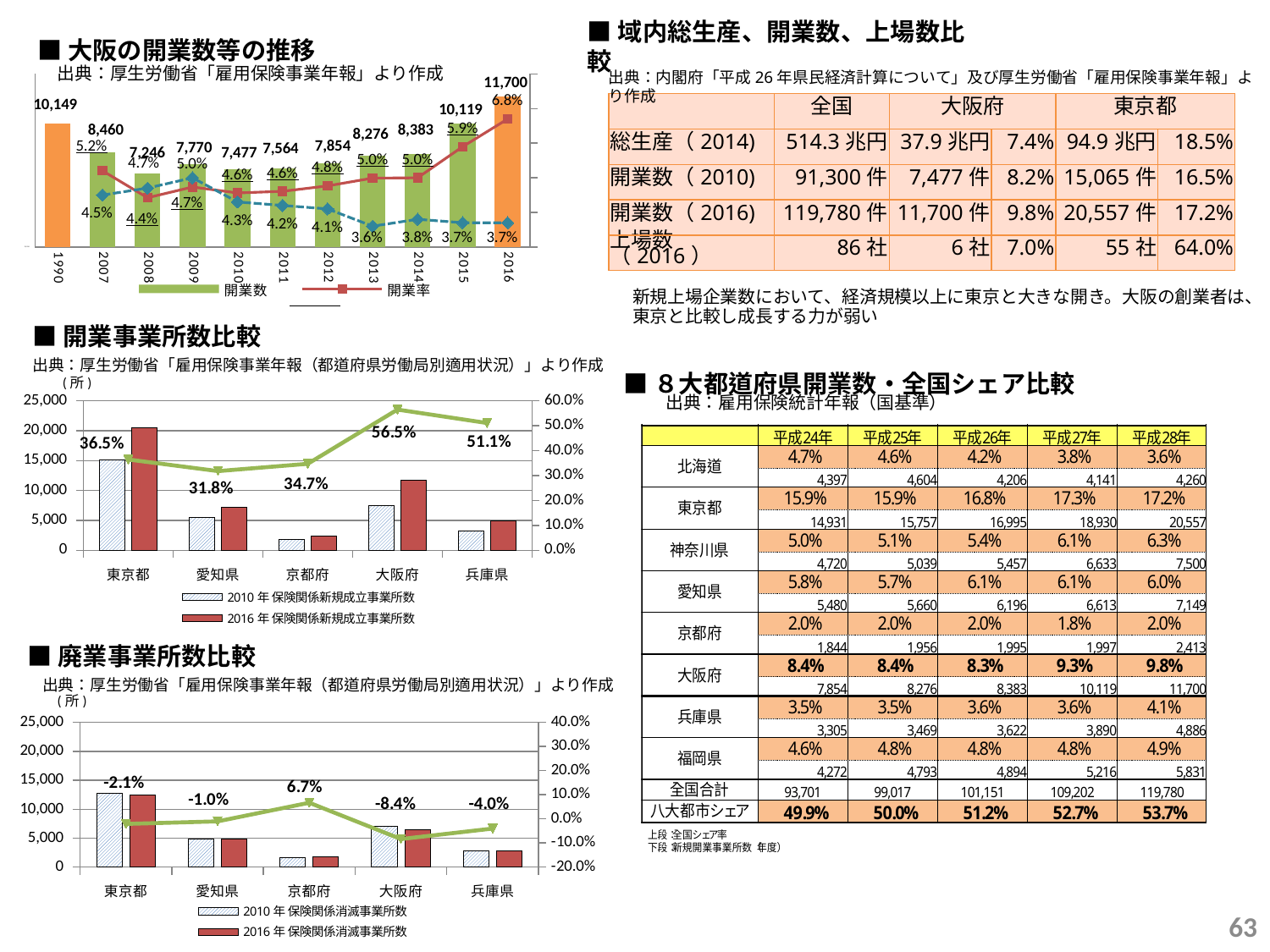
In the chart titled 開業事業所数比較, is the 2016 年 保険関係新規成立事業所数 bar for 東京都 greater or less than 15,000? greater In the chart titled 大阪の開業数等の推移, what is the 開業率 value for 2015? 5.9% In the chart titled 開業事業所数比較, which prefecture has the highest line value? 大阪府 In the chart titled 大阪の開業数等の推移, which is larger, the 開業数 for 1990 or for 2015? 1990 In the chart titled 大阪の開業数等の推移, what is the 開業数 value for 2016? 11,700 In the chart titled 廃業事業所数比較, which prefecture has the lowest line value? 大阪府 In the chart titled 大阪の開業数等の推移, does the 開業率 line rise or fall from 2013 to 2016? rise In the chart titled 開業事業所数比較, what is the line value shown for 大阪府? 56.5% In the chart titled 開業事業所数比較, how many prefectures are shown on the x axis? 5 In the chart titled 大阪の開業数等の推移, which year has the lowest 開業数 bar? 2008 In the chart titled 大阪の開業数等の推移, what is the difference between the 開業数 values for 2016 and 2015? 1,581 In the chart titled 廃業事業所数比較, what is the line value shown for 京都府? 6.7%